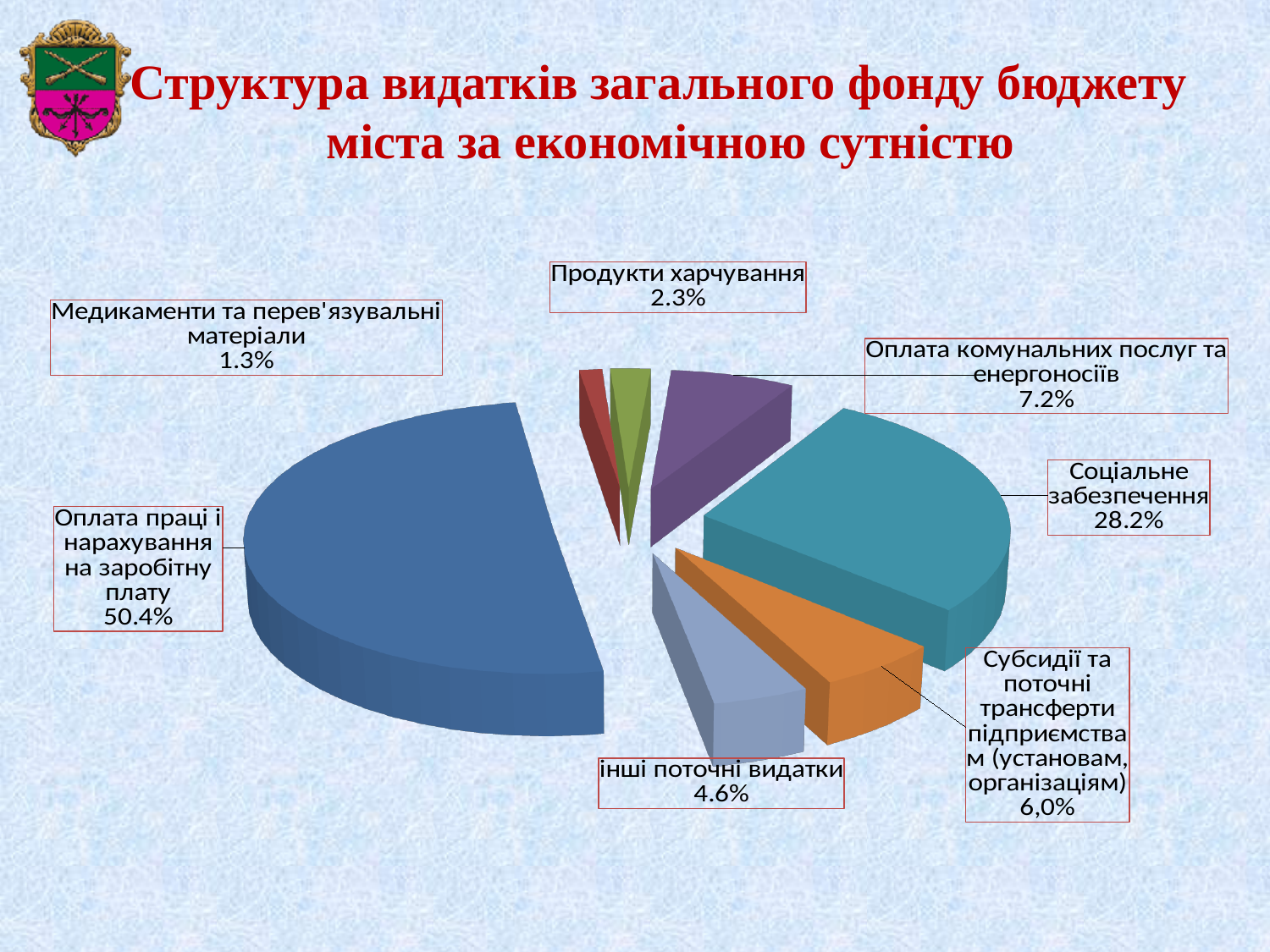
What share of the pie is labelled "Продукти харчування"? 2.3% Which category has the smallest slice of the pie? Медикаменти та перев'язувальні матеріали Which is larger: "Оплата комунальних послуг та енергоносіїв" or "інші поточні видатки"? Оплата комунальних послуг та енергоносіїв How many slices does the pie chart have? 7 What type of chart is shown on the slide? Pie chart What share of the pie is labelled "інші поточні видатки"? 4.6% What share of the pie is labelled "Оплата комунальних послуг та енергоносіїв"? 7.2% What share of the pie is labelled "Оплата праці і нарахування на заробітну плату"? 50.4% What share of the pie is labelled "Соціальне забезпечення"? 28.2% What is the difference in percentage points between "Оплата праці і нарахування на заробітну плату" and "Соціальне забезпечення"? 22.2 What share of the pie is labelled "Медикаменти та перев'язувальні матеріали"? 1.3% Which category has the largest slice of the pie? Оплата праці і нарахування на заробітну плату